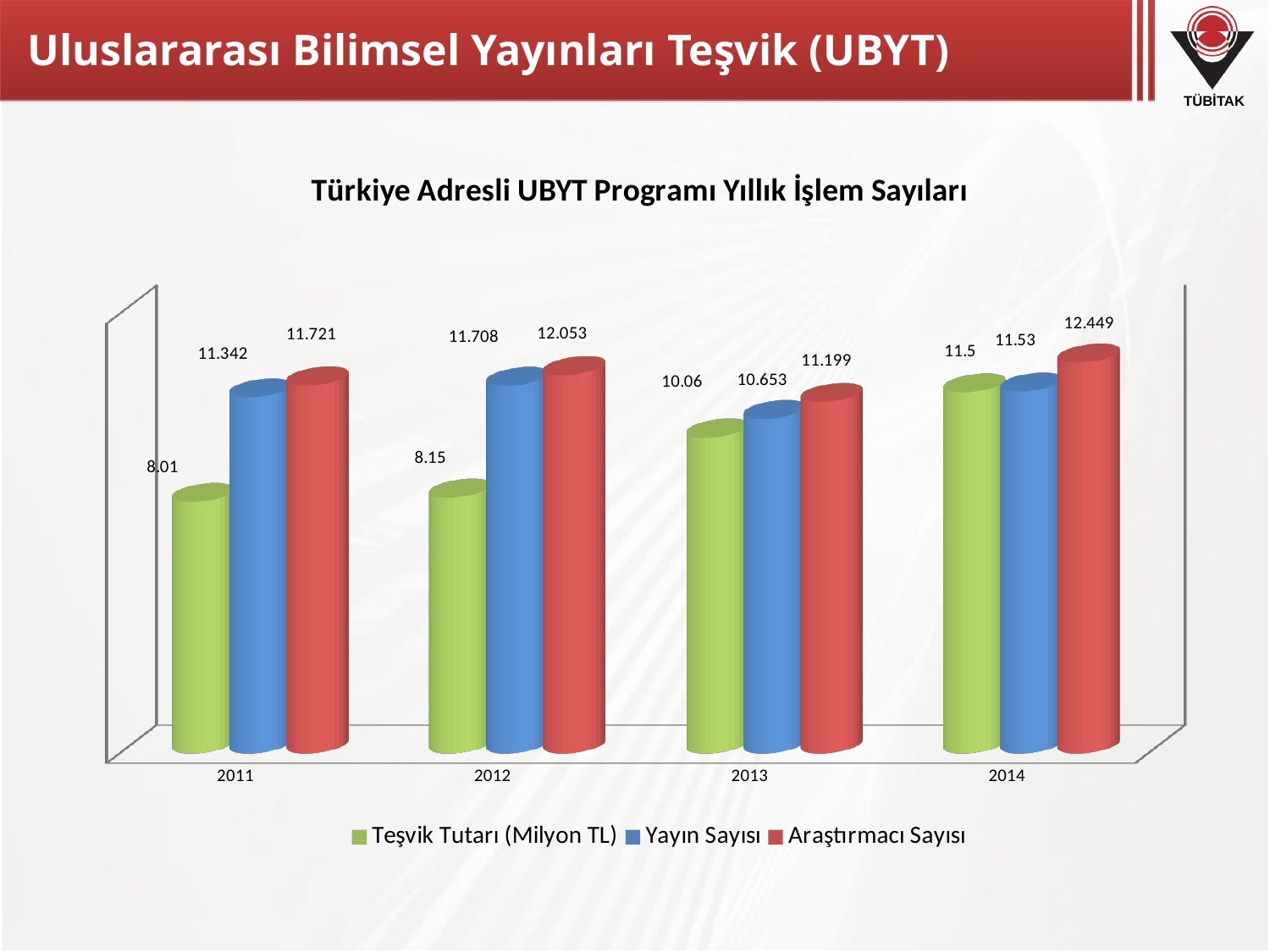
Does Teşvik Tutarı (Milyon TL) rise or fall from 2011 to 2014? Rise How many series does the legend list? 3 What is the Araştırmacı Sayısı value for 2014? 12.449 What is the title of the chart? Türkiye Adresli UBYT Programı Yıllık İşlem Sayıları In which year is Teşvik Tutarı (Milyon TL) lowest? 2011 What is the difference between the Teşvik Tutarı (Milyon TL) values for 2014 and 2011? 3.49 What is the Teşvik Tutarı (Milyon TL) value for 2011? 8.01 What kind of chart is shown on the slide? Bar chart What is the Yayın Sayısı value for 2013? 10.653 How many years are shown on the x axis? 4 In 2013, which is larger: Yayın Sayısı or Araştırmacı Sayısı? Araştırmacı Sayısı In which year is Araştırmacı Sayısı highest? 2014